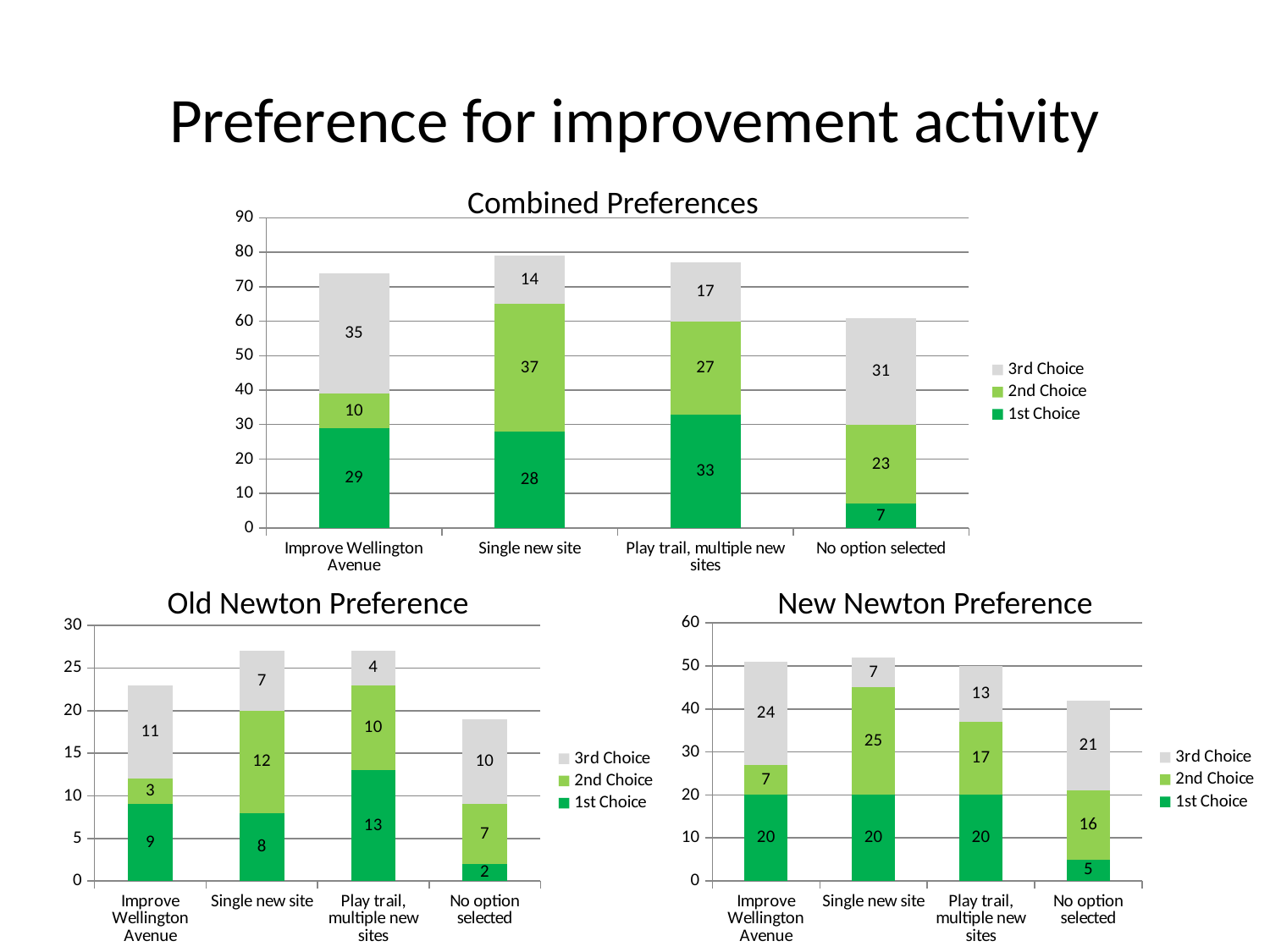
In the Combined Preferences chart, what is the total of the stacked bar for Improve Wellington Avenue? 74 In the New Newton Preference chart, which is larger: the 2nd Choice value for Single new site or for Play trail, multiple new sites? Single new site In the New Newton Preference chart, what is the total of the stacked bar for No option selected? 42 In the Old Newton Preference chart, what is the total of the stacked bar for No option selected? 19 In the Old Newton Preference chart, what is the 2nd Choice value for Single new site? 12 In the Combined Preferences chart, what is the difference between the 3rd Choice values for Improve Wellington Avenue and Single new site? 21 In the Combined Preferences chart, which category has the highest 2nd Choice value? Single new site In the Combined Preferences chart, what is the 1st Choice value for Play trail, multiple new sites? 33 In the Old Newton Preference chart, which category has the lowest 1st Choice value? No option selected How many series does the legend of the Combined Preferences chart list? 3 In the New Newton Preference chart, what is the 3rd Choice value for Improve Wellington Avenue? 24 What kind of chart is the Old Newton Preference chart? Stacked bar chart